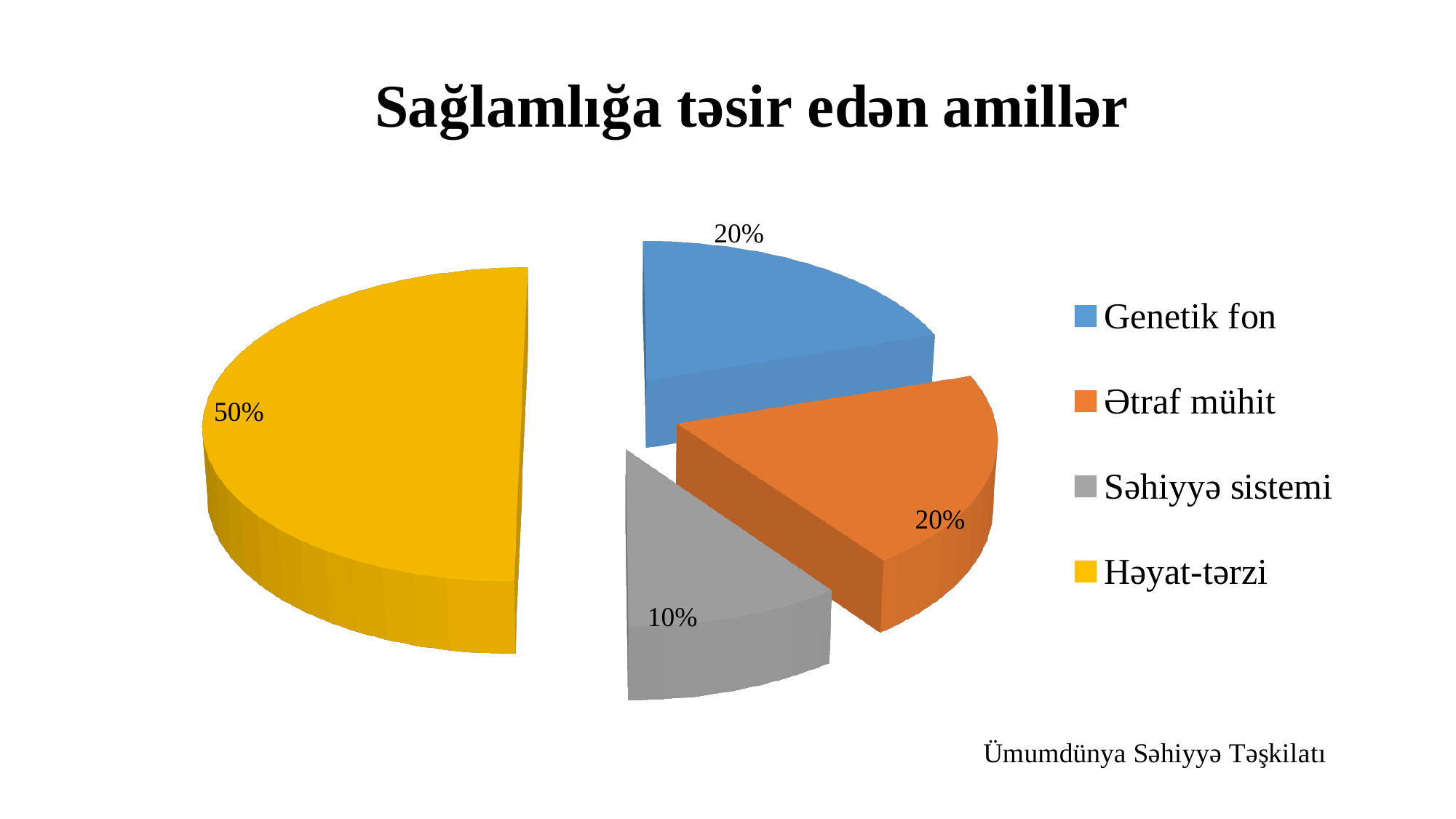
What colour is the slice for Həyat-tərzi? Yellow What is the value shown for Səhiyyə sistemi? 10% Which category has the smallest slice of the pie? Səhiyyə sistemi What is the value shown for Genetik fon? 20% Which category has the largest slice of the pie? Həyat-tərzi Which is larger, the value for Genetik fon or the value for Səhiyyə sistemi? Genetik fon What kind of chart is shown on the slide? Pie chart What share of the pie does Həyat-tərzi have? 50% What is the title of the slide? Sağlamlığa təsir edən amillər What is the value shown for Ətraf mühit? 20% How many categories does the pie chart have? 4 What is the difference between the values for Həyat-tərzi and Səhiyyə sistemi? 40%